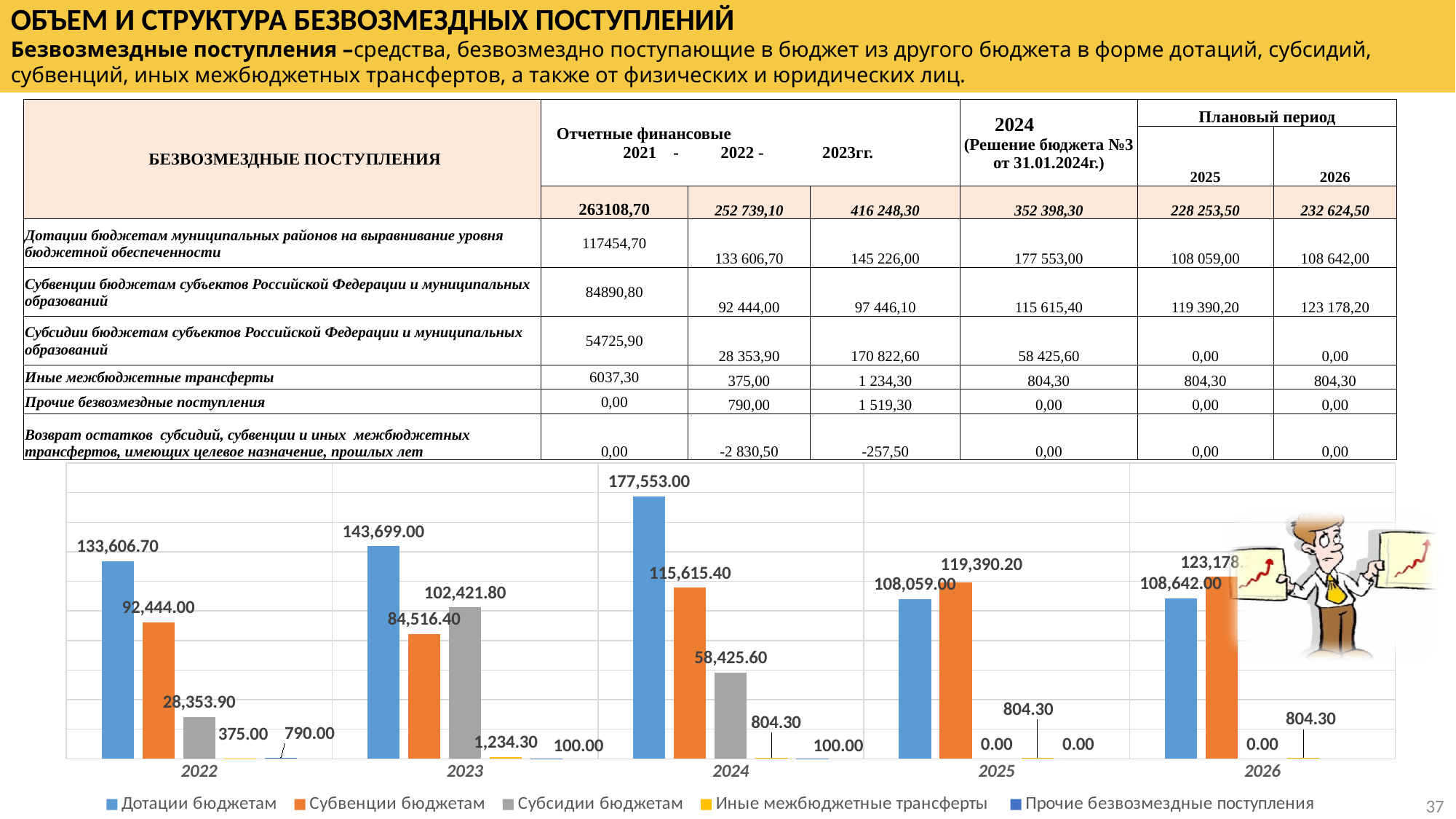
How many series does the chart legend list? 5 In the chart, what is the value for Дотации бюджетам in 2024? 177,553.00 In the chart, what is the difference between Дотации бюджетам in 2024 and in 2023? 33,854.00 In the chart, what is the value for Субвенции бюджетам in 2025? 119,390.20 In the chart, what is the value for Иные межбюджетные трансферты in 2022? 375.00 How many year categories are shown on the x axis of the chart? 5 Which colour represents Субвенции бюджетам in the chart legend? orange In the chart, which is larger in 2025: Дотации бюджетам or Субвенции бюджетам? Субвенции бюджетам In the chart, what is the value for Субсидии бюджетам in 2023? 102,421.80 What kind of chart is shown at the bottom of the slide? bar chart In which year does Дотации бюджетам reach its highest value in the chart? 2024 In which year is the value for Субсидии бюджетам lowest among 2022, 2023 and 2024 in the chart? 2022